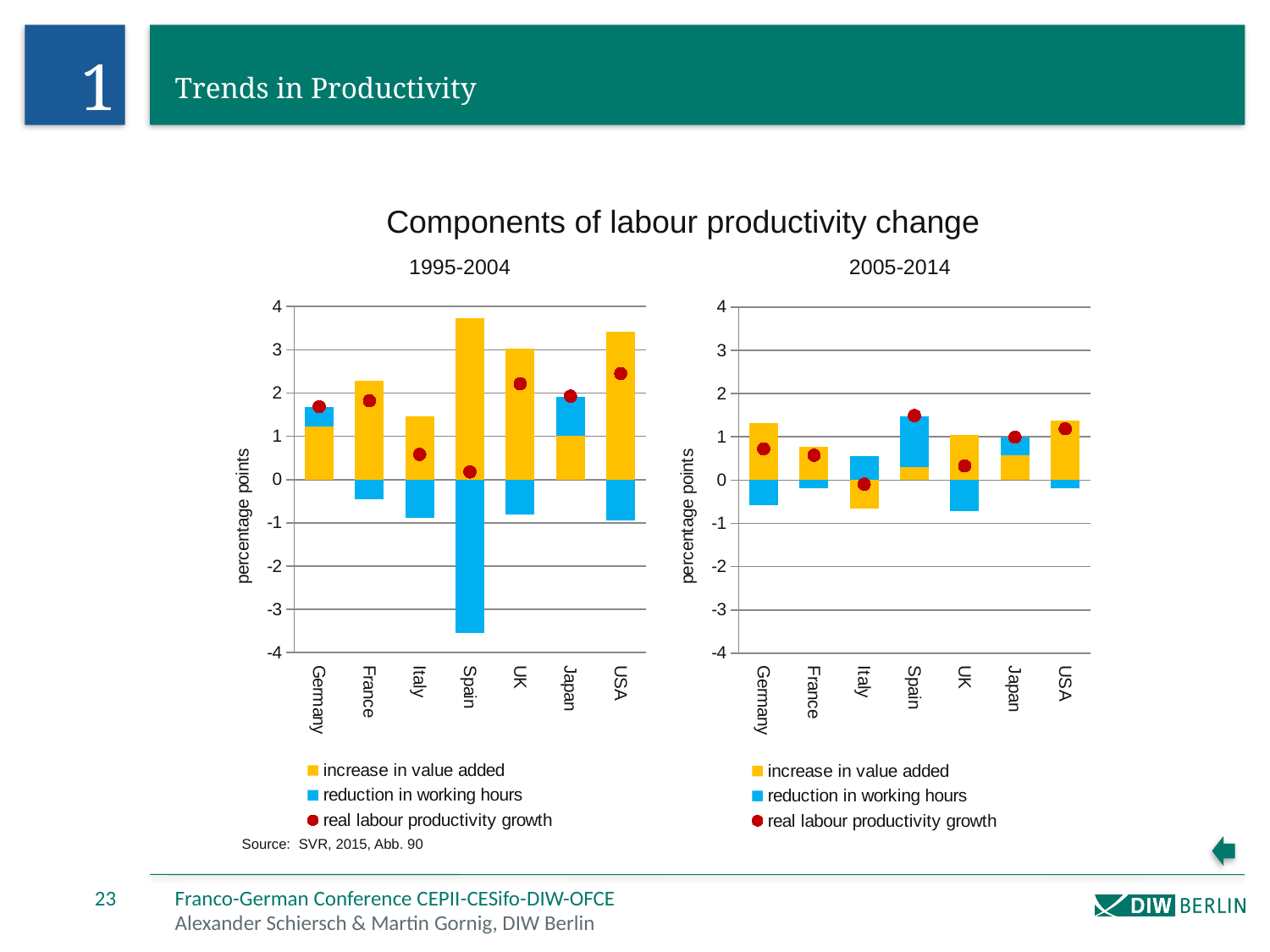
In the 1995-2004 chart, which country has the lowest real labour productivity growth? Spain In the 2005-2014 chart, which country has the highest real labour productivity growth? Spain In the 1995-2004 chart, is the increase in value added for Spain greater or less than 3? greater In the 2005-2014 chart, which country has the lowest real labour productivity growth? Italy In the 2005-2014 chart, is the real labour productivity growth for the UK greater or less than 1? less In the 1995-2004 chart, which country has the largest increase in value added? Spain In the 1995-2004 chart, which is larger, the increase in value added for Spain or for the UK? Spain What is the overall title above the two charts? Components of labour productivity change How many series does the legend of the 1995-2004 chart list? 3 How many countries are shown on the x axis of the 2005-2014 chart? 7 In the 1995-2004 chart, is the reduction in working hours for Spain greater or less than -3? less What kind of chart is the 1995-2004 chart? bar chart